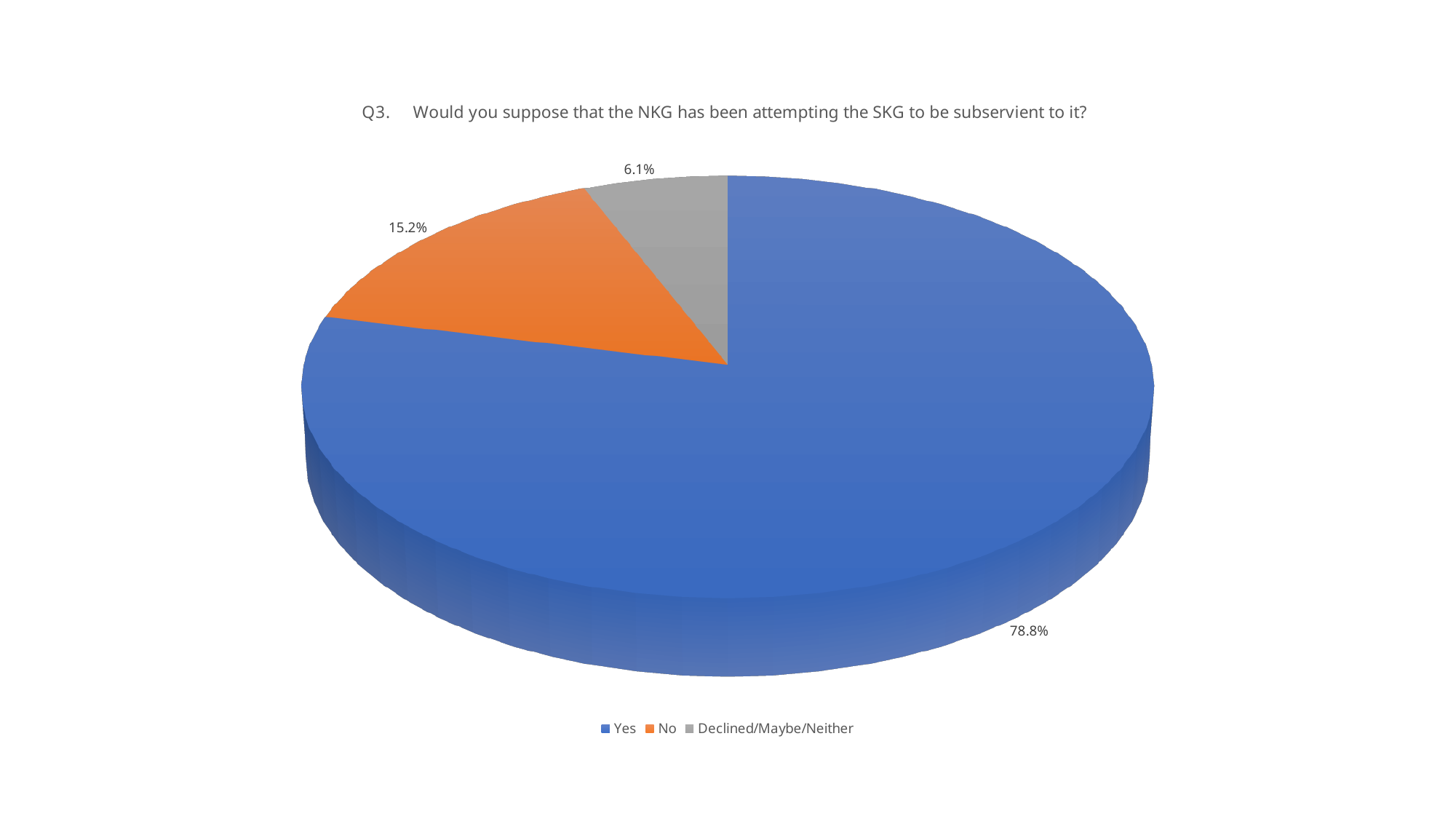
What percentage of respondents answered Declined/Maybe/Neither? 6.1% Which response has the smallest share of the pie? Declined/Maybe/Neither What percentage of respondents answered No? 15.2% What colour is the slice representing No? orange Which response has the largest share of the pie? Yes What is the difference in percentage points between the Yes and No shares? 63.6 Which is larger, the share for No or the share for Declined/Maybe/Neither? No What is the difference in percentage points between the No and Declined/Maybe/Neither shares? 9.1 What kind of chart is shown on the slide? pie chart What percentage of respondents answered Yes? 78.8% What is the title of the chart? Q3. Would you suppose that the NKG has been attempting the SKG to be subservient to it? How many categories does the pie chart have? 3